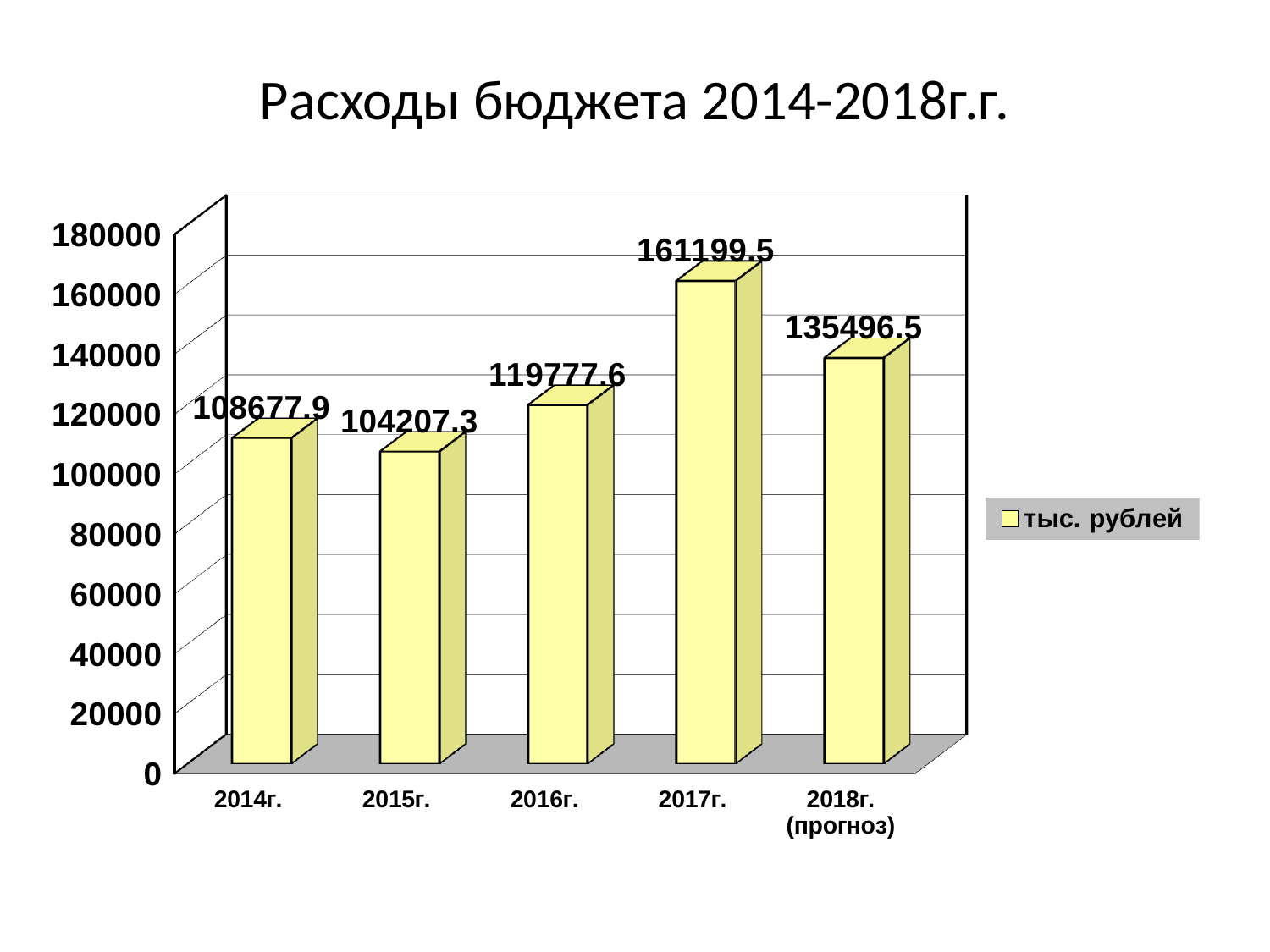
Which year has the highest value? 2017г. What is the value for 2016г.? 119777.6 Which year has the lowest value? 2015г. Is the value for 2017г. greater or less than 140000? greater What kind of chart is shown on the slide? bar chart What is the value for 2018г. (прогноз)? 135496.5 Which is larger, the value for 2018г. (прогноз) or the value for 2016г.? 2018г. (прогноз) What is the value for 2014г.? 108677.9 How many years are shown on the x axis? 5 What is the difference between the values for 2014г. and 2015г.? 4470.6 What is the difference between the values for 2017г. and 2016г.? 41421.9 What is the legend entry of the chart? тыс. рублей